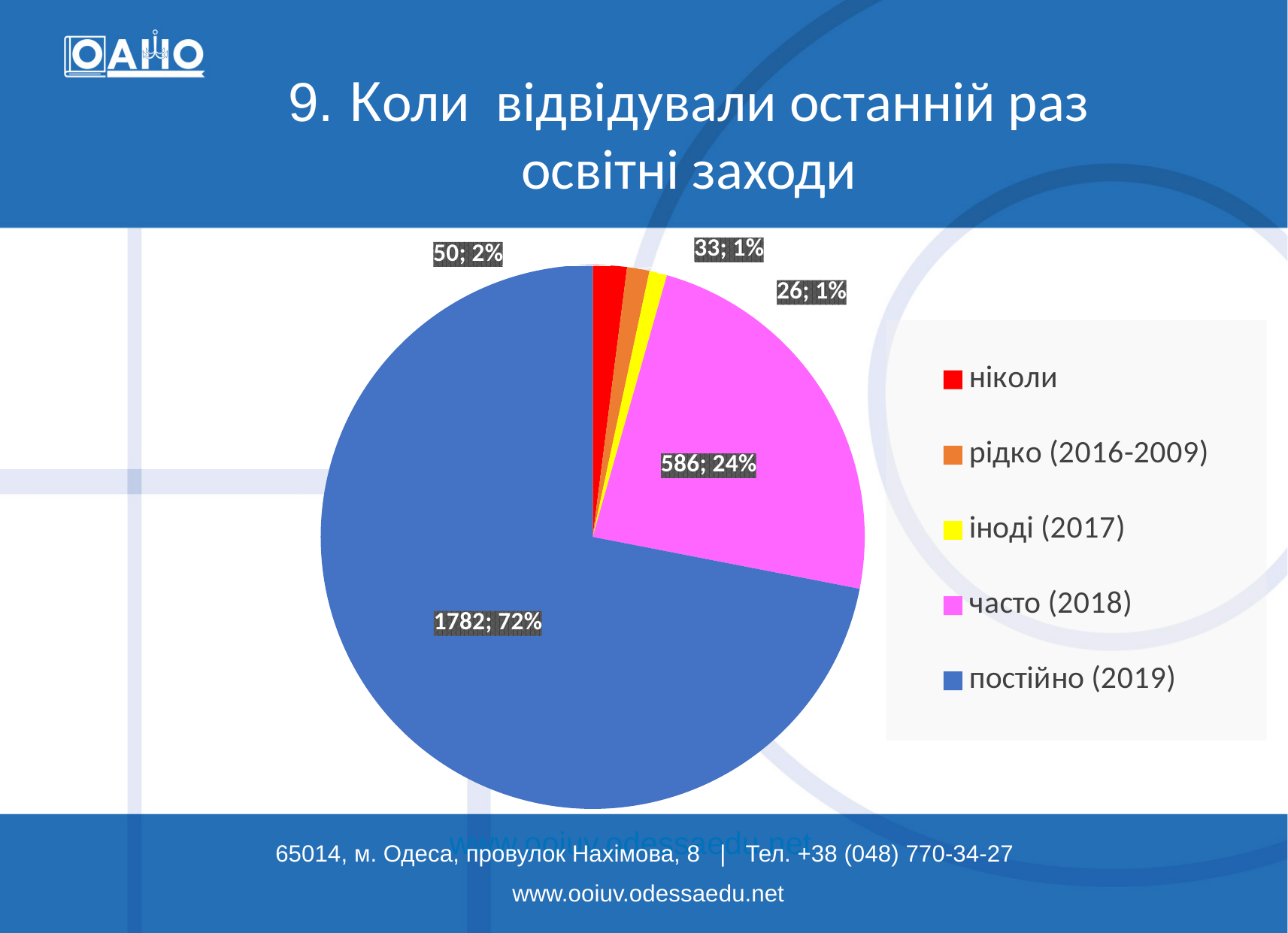
What is the value for "іноді (2017)" in the pie chart? 26 What is the difference between the values for "постійно (2019)" and "часто (2018)"? 1196 What kind of chart is shown on the slide? pie chart What is the value for "ніколи" in the pie chart? 50 What is the value for "постійно (2019)" in the pie chart? 1782 How many categories does the legend of the pie chart list? 5 What percentage share does "часто (2018)" have in the pie chart? 24% Which category has the smallest slice in the pie chart? іноді (2017) What is the value for "рідко (2016-2009)" in the pie chart? 33 Which is larger in the pie chart: the value for "ніколи" or the value for "рідко (2016-2009)"? ніколи Which category has the largest slice in the pie chart? постійно (2019) What colour is the slice for "часто (2018)" in the pie chart? pink